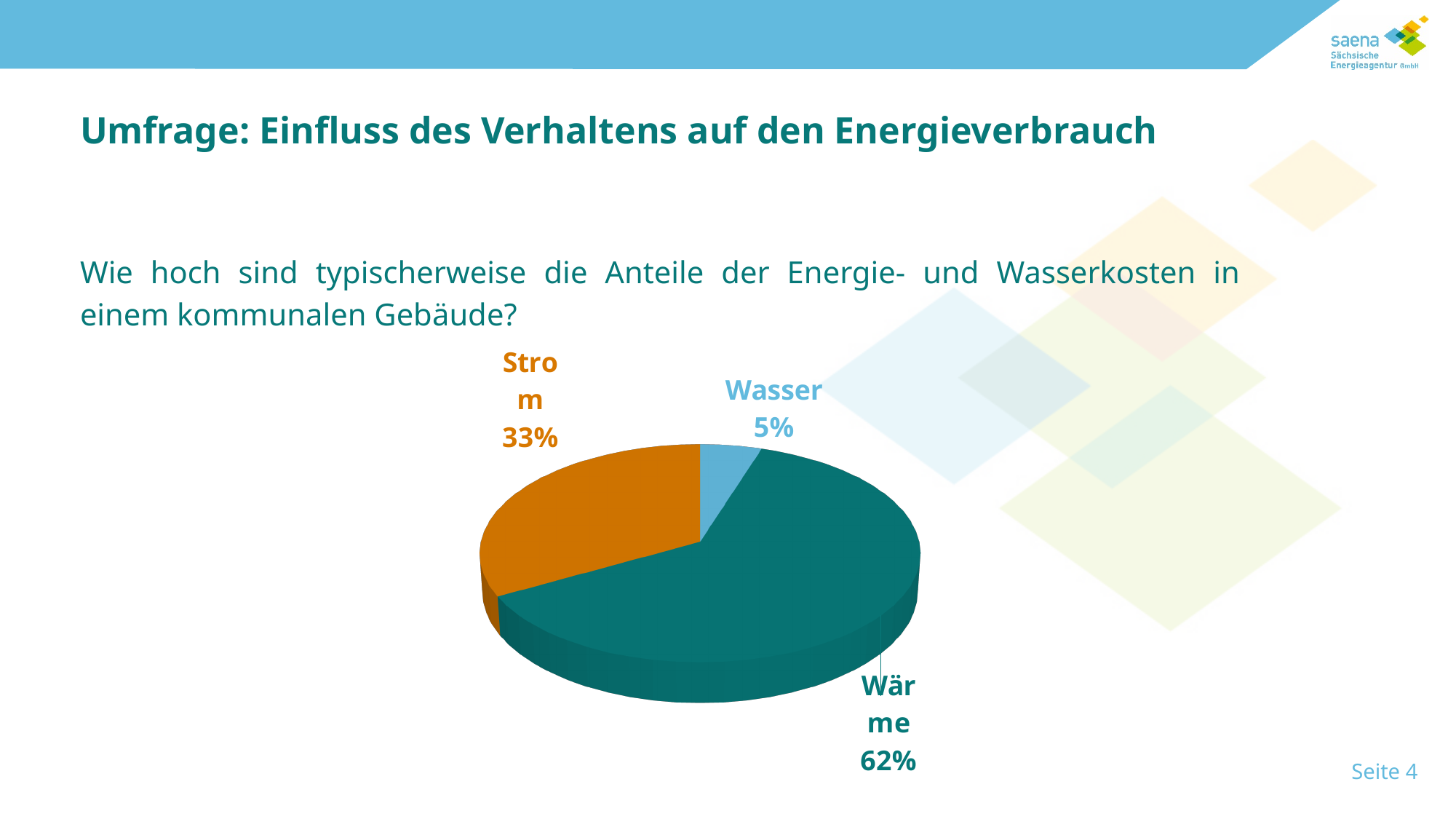
Which is larger, the share for Strom or the share for Wasser? Strom What is the difference in percentage points between Strom and Wasser? 28 What is the difference in percentage points between Wärme and Strom? 29 What share of the pie does Strom have? 33% Which category has the largest slice of the pie? Wärme What kind of chart is shown on the slide? Pie chart What colour is the Strom slice? Orange What share of the pie does Wasser have? 5% Which category has the smallest slice of the pie? Wasser What share of the pie does Wärme have? 62% How many slices does the pie chart have? 3 What colour is the Wärme slice? Teal